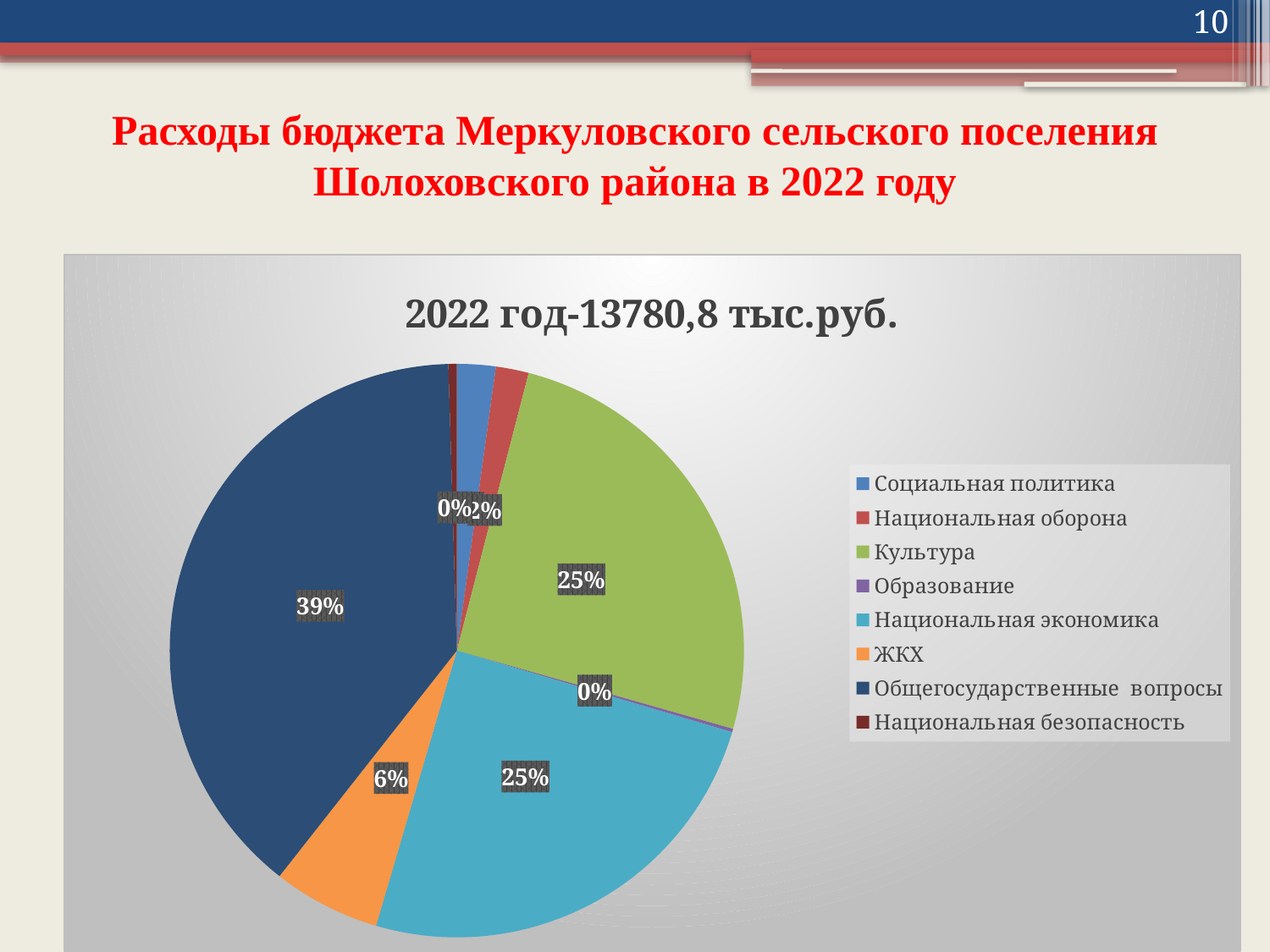
Which has the larger share, Общегосударственные вопросы or Культура? Общегосударственные вопросы What share of the pie does Общегосударственные вопросы have? 39% What kind of chart is shown on the slide? pie chart What share of the pie does Национальная экономика have? 25% What is the title of the pie chart? 2022 год-13780,8 тыс.руб. How many categories does the legend of the pie chart list? 8 Which category has the largest share of the pie chart? Общегосударственные вопросы By how many percentage points does the share of Общегосударственные вопросы exceed the share of ЖКХ? 33 percentage points Which has the larger share, ЖКХ or Национальная экономика? Национальная экономика What share of the pie is labelled for Образование? 0%